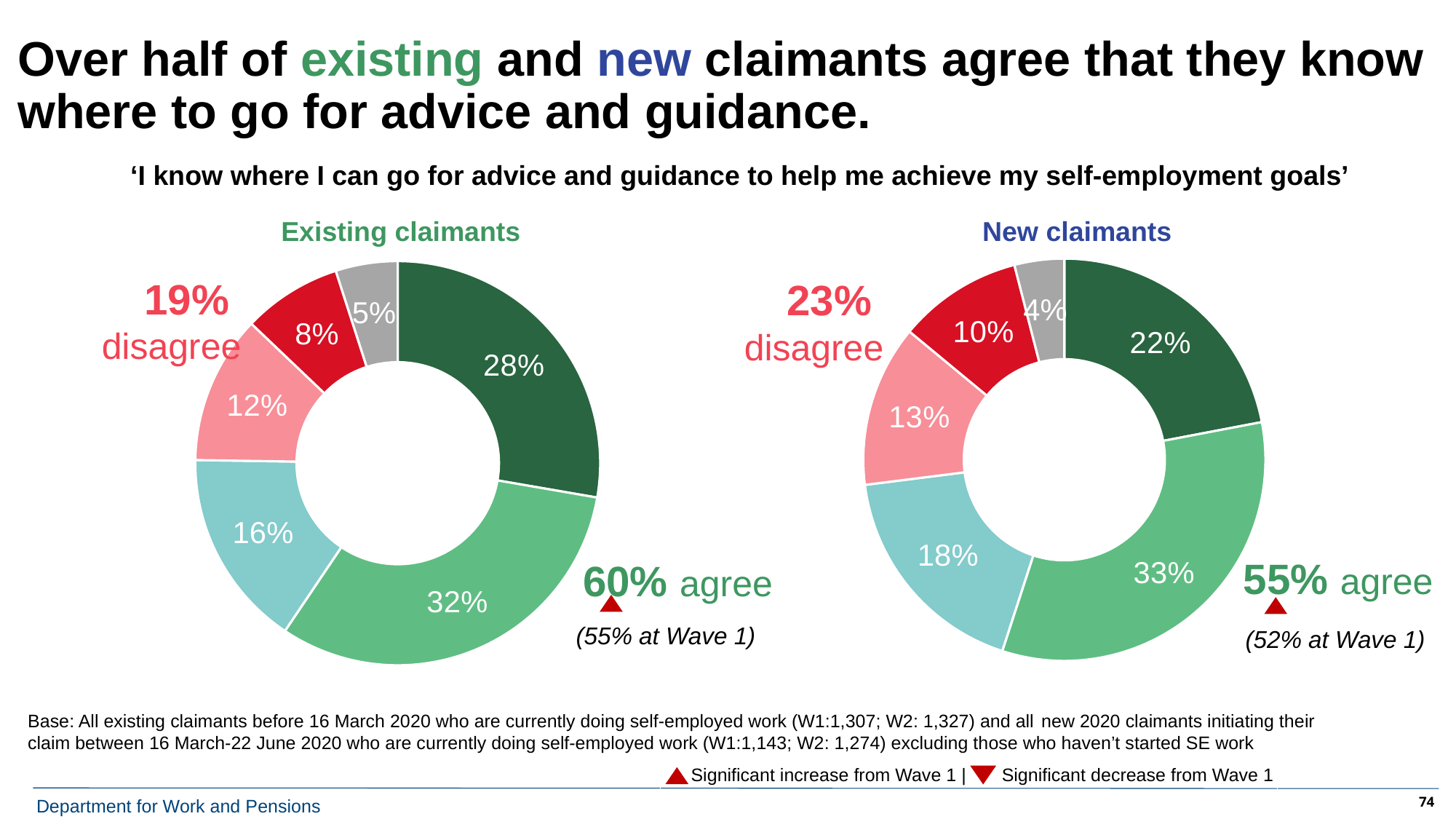
In the Existing claimants chart, what was the agree percentage at Wave 1? 55% Which group has the higher disagree percentage, Existing claimants or New claimants? New claimants In the New claimants chart, what was the agree percentage at Wave 1? 52% In the Existing claimants chart, what is the value of the largest slice? 32% In the Existing claimants chart, what is the value of the light blue slice? 16% In the New claimants chart, what is the value of the grey slice? 4% What kind of chart is used for the Existing claimants data? Doughnut (pie) chart In the Existing claimants chart, what percentage agree? 60% In the New claimants chart, what is the value of the smallest slice? 4% In the New claimants chart, what percentage disagree? 23% What is the difference between the agree percentage for Existing claimants and for New claimants? 5 percentage points How many slices does the New claimants chart have? 6